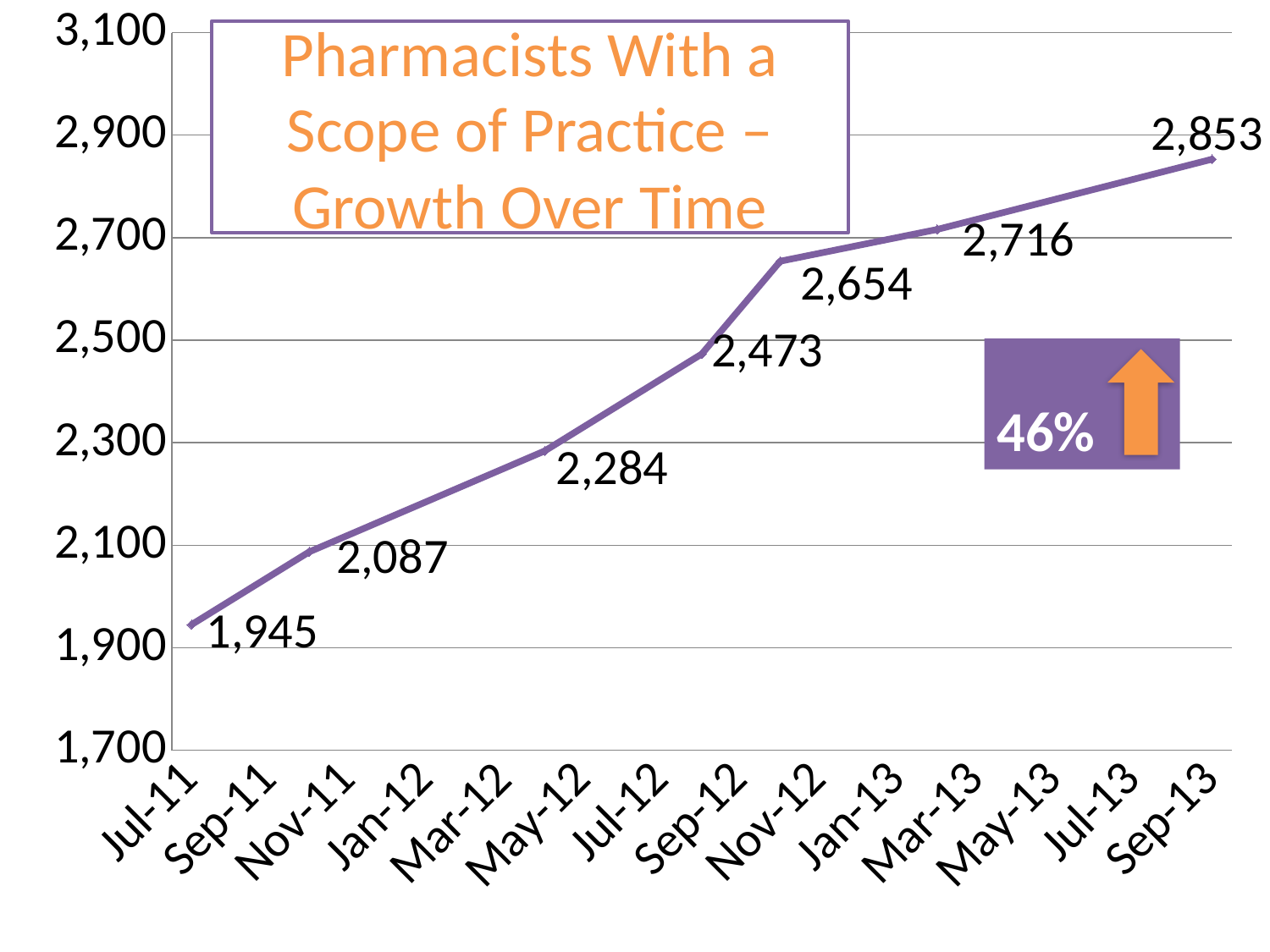
What is the title of the chart? Pharmacists With a Scope of Practice – Growth Over Time What is the lowest value labelled on the line? 1,945 What is the highest value labelled on the line? 2,853 What percentage growth is shown in the purple box with the orange arrow? 46% Do the values rise or fall over time from Jul-11 to Sep-13? Rise What is the difference between the data points labelled 2,654 and 2,473? 181 What is the value of the last data point, at Sep-13? 2,853 What is the value of the first data point, at Jul-11? 1,945 Which is larger, the data point labelled 2,716 or the one labelled 2,654? 2,716 What type of chart is shown on the slide? Line chart How many labelled data points are on the line? 7 What is the difference between the last value (2,853) and the first value (1,945)? 908